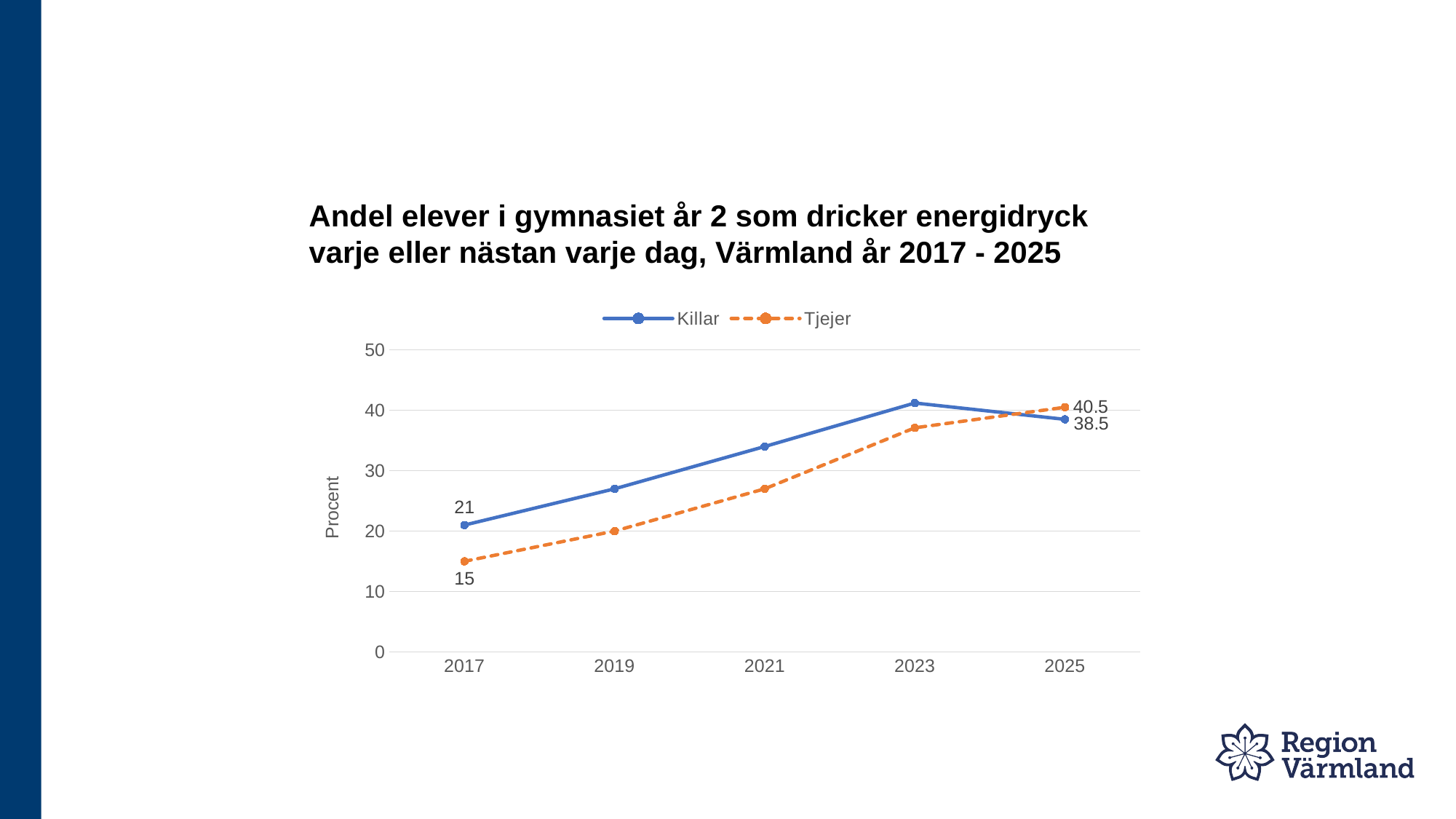
How many years are shown on the x axis? 5 Is the value for Killar in 2023 greater or less than 40? greater Is the value for Tjejer in 2019 greater or less than 30? less What kind of chart is shown on the slide? Line chart What is the value for Tjejer in 2025? 40.5 Which series has the higher value in 2021, Killar or Tjejer? Killar What is the difference between the Killar and Tjejer values in 2017? 6 How many series does the legend list? 2 What is the value for Tjejer in 2017? 15 What is the value for Killar in 2025? 38.5 What is the difference between the Tjejer and Killar values in 2025? 2 What is the value for Killar in 2017? 21